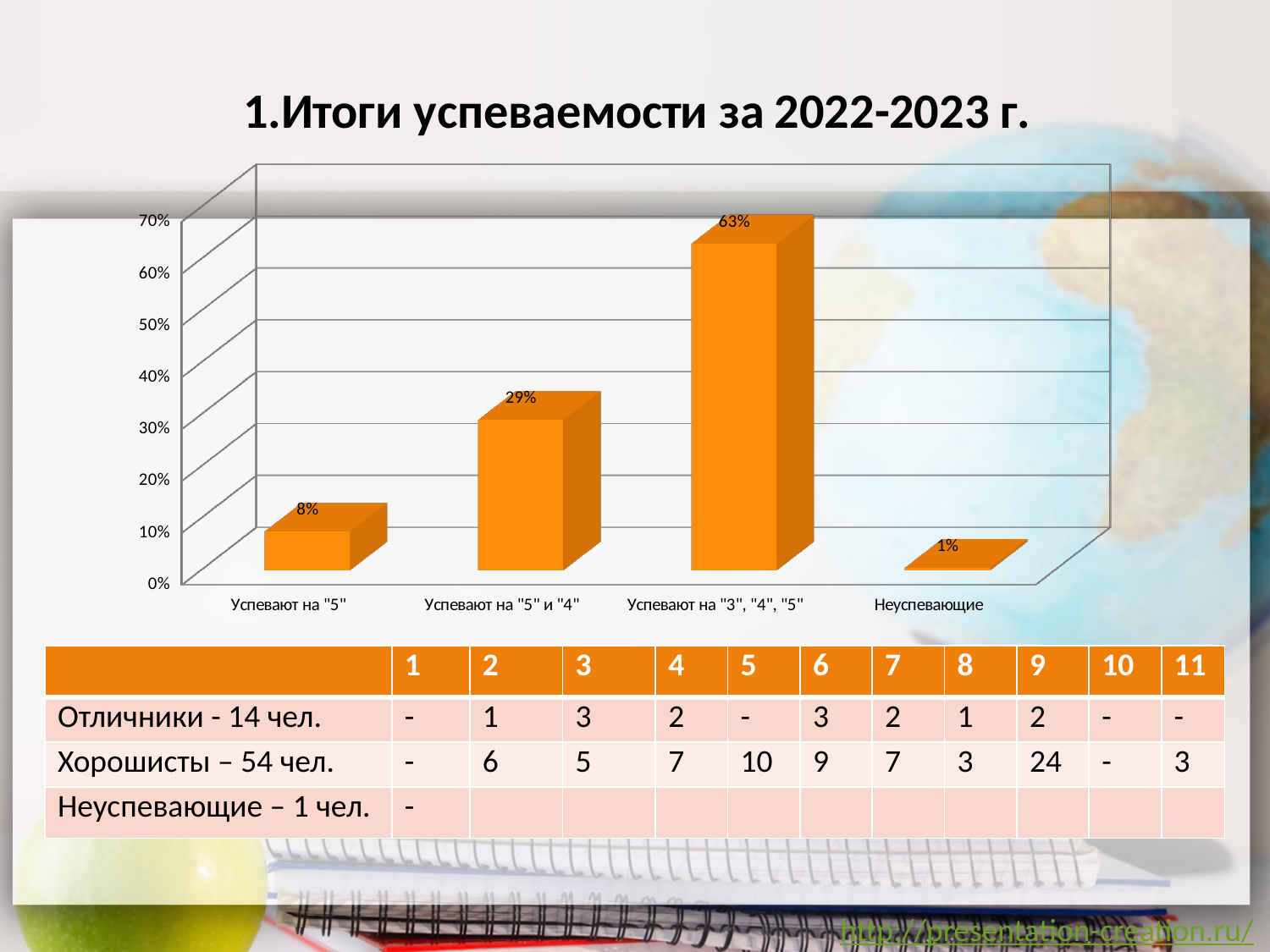
Which is larger, the value for Успевают на "5" or the value for Успевают на "5" и "4"? Успевают на "5" и "4" Which category has the highest value? Успевают на "3", "4", "5" What is the value for Успевают на "5" и "4"? 29% What is the difference between the values for Успевают на "3", "4", "5" and Успевают на "5" и "4"? 34% How many categories are shown on the chart? 4 Which category has the lowest value? Неуспевающие What is the value for Успевают на "3", "4", "5"? 63% Is the value for Успевают на "3", "4", "5" greater or less than 50%? greater What is the value for Успевают на "5"? 8% What kind of chart is shown on the slide? bar chart What is the highest value shown on the vertical axis of the chart? 70% What is the value for Неуспевающие? 1%